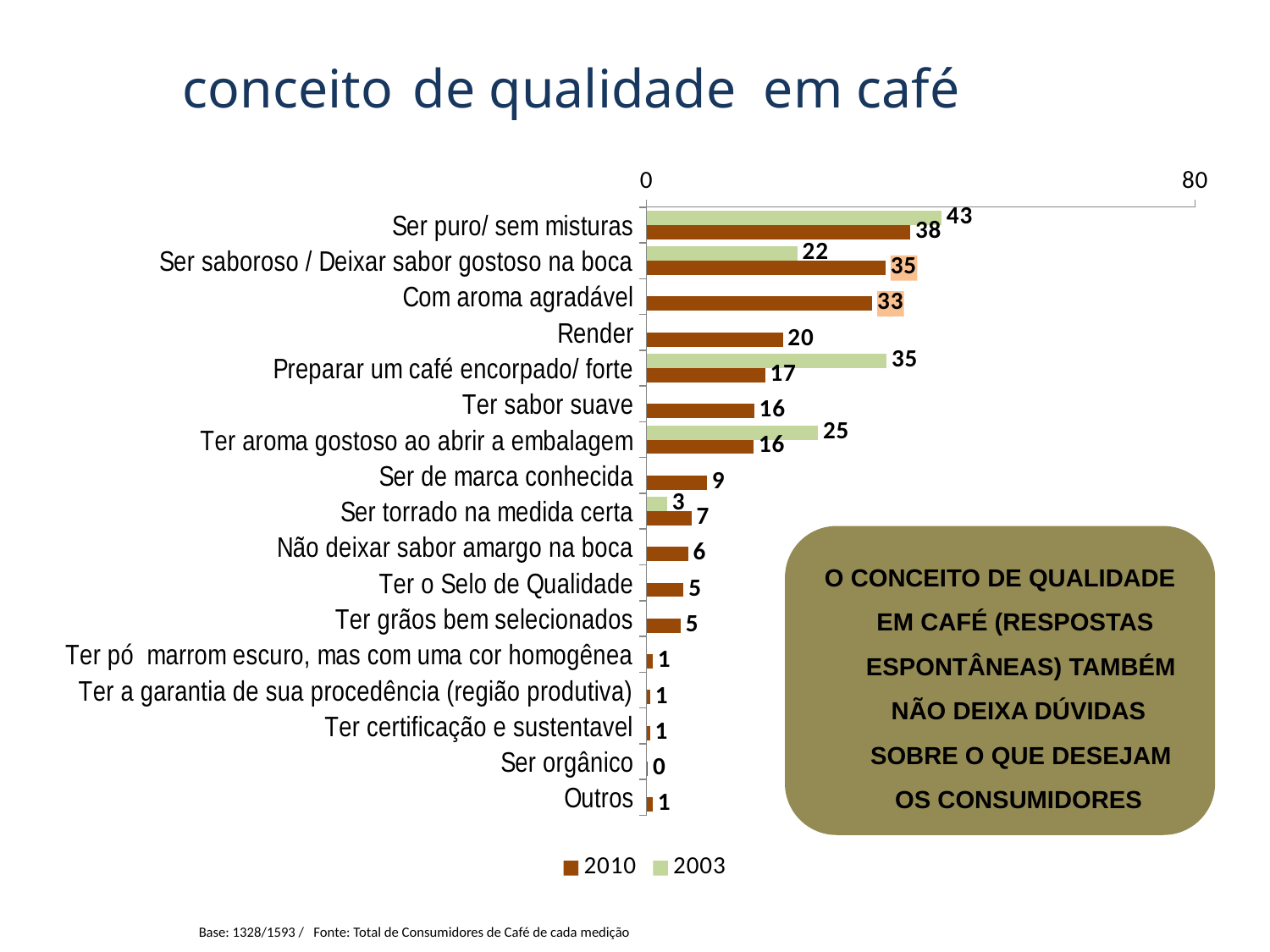
Which category has the highest 2010 value? Ser puro/ sem misturas What is the 2003 value for "Preparar um café encorpado/ forte"? 35 What is the 2003 value for "Ser torrado na medida certa"? 3 For "Ter aroma gostoso ao abrir a embalagem", which year has the larger value, 2003 or 2010? 2003 Which series does the green colour represent in the legend? 2003 What is the 2010 value for "Ser puro/ sem misturas"? 38 What kind of chart is shown on the slide? Bar chart What is the 2010 value for "Com aroma agradável"? 33 Which category has the lowest 2010 value? Ser orgânico How many categories are shown on the chart? 17 How many series does the legend list? 2 What is the difference between the 2003 and 2010 values for "Ser saboroso / Deixar sabor gostoso na boca"? 13